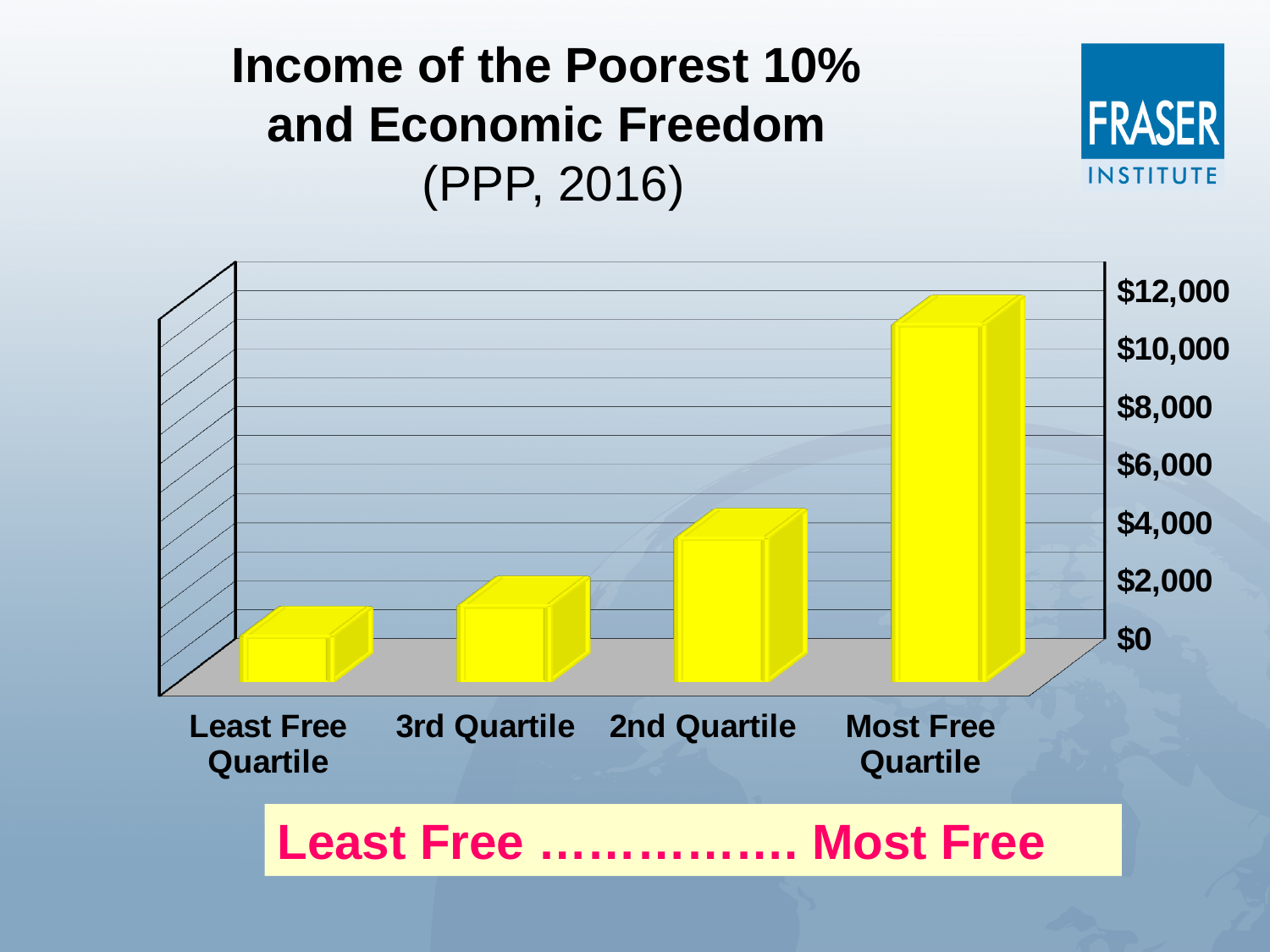
Do the values rise or fall moving from the Least Free Quartile to the Most Free Quartile along the x axis? rise Which category has the highest income of the poorest 10%? Most Free Quartile Which is larger, the value for the 2nd Quartile or the value for the 3rd Quartile? 2nd Quartile Is the value for the Least Free Quartile greater or less than $2,000? less Is the value for the 3rd Quartile greater or less than $4,000? less Is the value for the Most Free Quartile greater or less than $10,000? greater What kind of chart is shown on the slide? bar chart Which category has the lowest income of the poorest 10%? Least Free Quartile Which is larger, the value for the Least Free Quartile or the value for the Most Free Quartile? Most Free Quartile How many categories are shown on the x axis of the chart? 4 What colour are the bars in the chart? yellow What is the title of the chart on the slide? Income of the Poorest 10% and Economic Freedom (PPP, 2016)